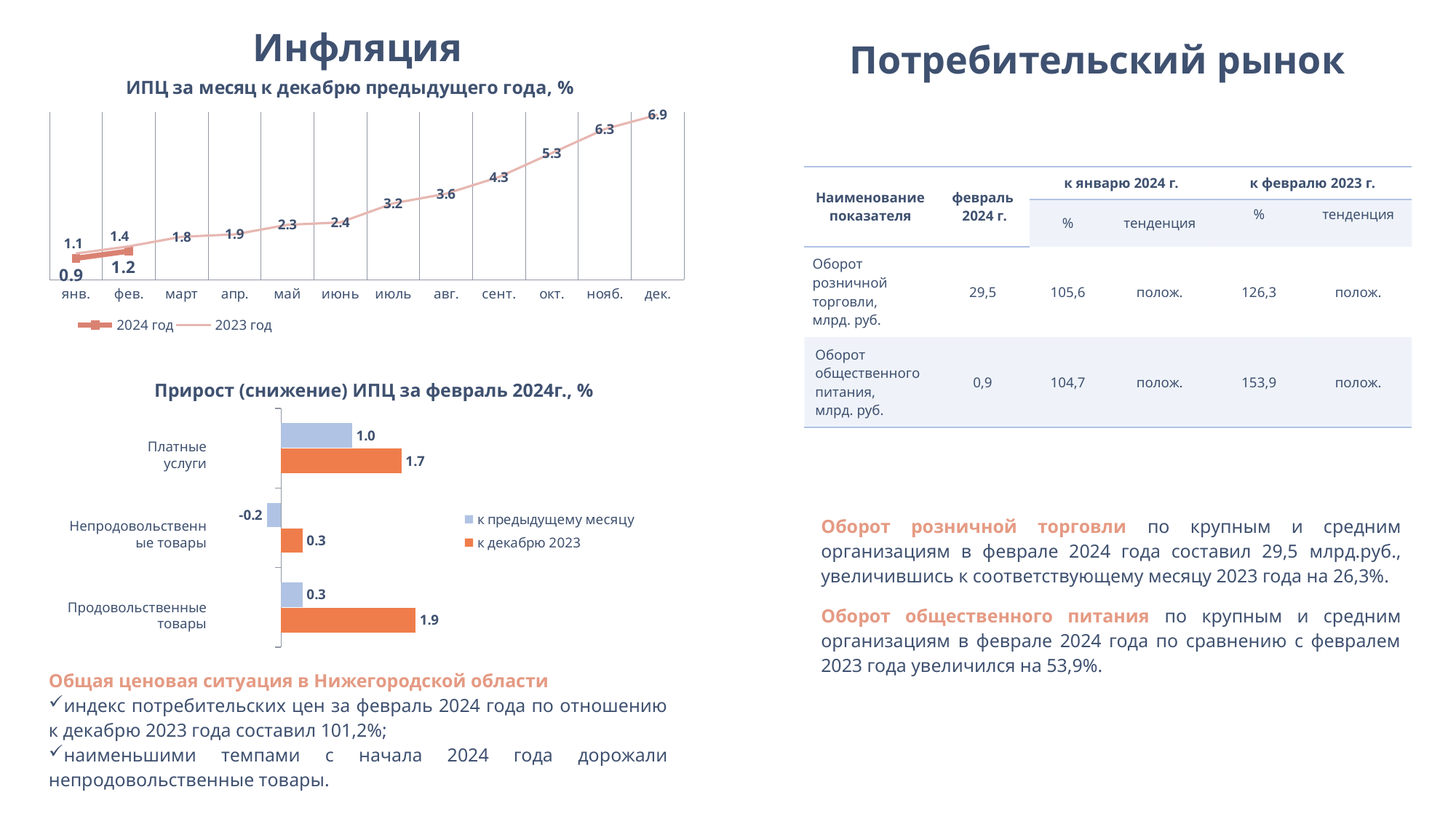
In the chart 'ИПЦ за месяц к декабрю предыдущего года, %', how many series does the legend list? 2 In the chart 'ИПЦ за месяц к декабрю предыдущего года, %', what is the value for фев. in the 2024 год series? 1.2 In the chart 'Прирост (снижение) ИПЦ за февраль 2024г., %', which category has the highest value in the 'к предыдущему месяцу' series? Платные услуги In the chart 'ИПЦ за месяц к декабрю предыдущего года, %', what is the difference between the 2023 год and 2024 год values for янв.? 0.2 In the chart 'ИПЦ за месяц к декабрю предыдущего года, %', does the 2023 год series rise or fall from янв. to дек.? rises In the chart 'Прирост (снижение) ИПЦ за февраль 2024г., %', what is the value for Продовольственные товары in the 'к декабрю 2023' series? 1.9 In the chart 'Прирост (снижение) ИПЦ за февраль 2024г., %', what is the difference between the 'к декабрю 2023' and 'к предыдущему месяцу' values for Платные услуги? 0.7 What kind of chart is 'Прирост (снижение) ИПЦ за февраль 2024г., %'? bar chart In the chart 'Прирост (снижение) ИПЦ за февраль 2024г., %', what is the value for Непродовольственные товары in the 'к предыдущему месяцу' series? -0.2 In the chart 'ИПЦ за месяц к декабрю предыдущего года, %', what is the value for дек. in the 2023 год series? 6.9 In the chart 'ИПЦ за месяц к декабрю предыдущего года, %', how many months are shown on the x axis? 12 In the chart 'ИПЦ за месяц к декабрю предыдущего года, %', which month has the lowest value in the 2023 год series? янв.